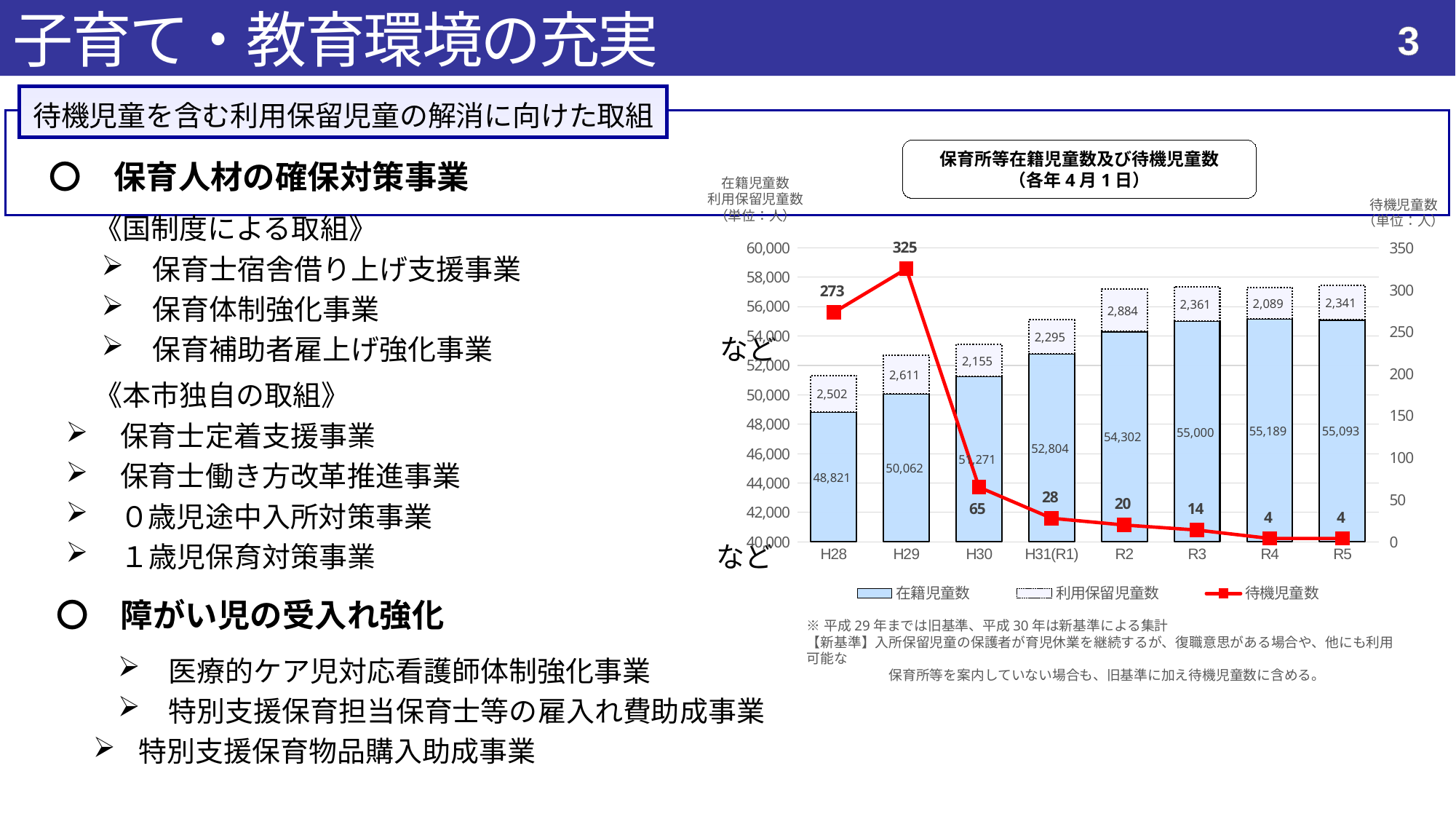
What is the 在籍児童数 value for R2? 54,302 In which year is the 待機児童数 highest? H29 What is the difference in 待機児童数 between H29 and H28? 52 What is the 利用保留児童数 value for H31(R1)? 2,295 Which is larger, the 利用保留児童数 for H29 or for H30? H29 How many years (categories) are shown on the x axis of the chart? 8 What is the 待機児童数 value for H29? 325 What is the total of the stacked bar (在籍児童数 plus 利用保留児童数) for R5? 57,434 Does the 待機児童数 line generally rise or fall from H29 to R5? fall In which year is the 利用保留児童数 lowest? R4 What is the title of the chart on the slide? 保育所等在籍児童数及び待機児童数（各年4月1日） How many series does the chart legend list? 3